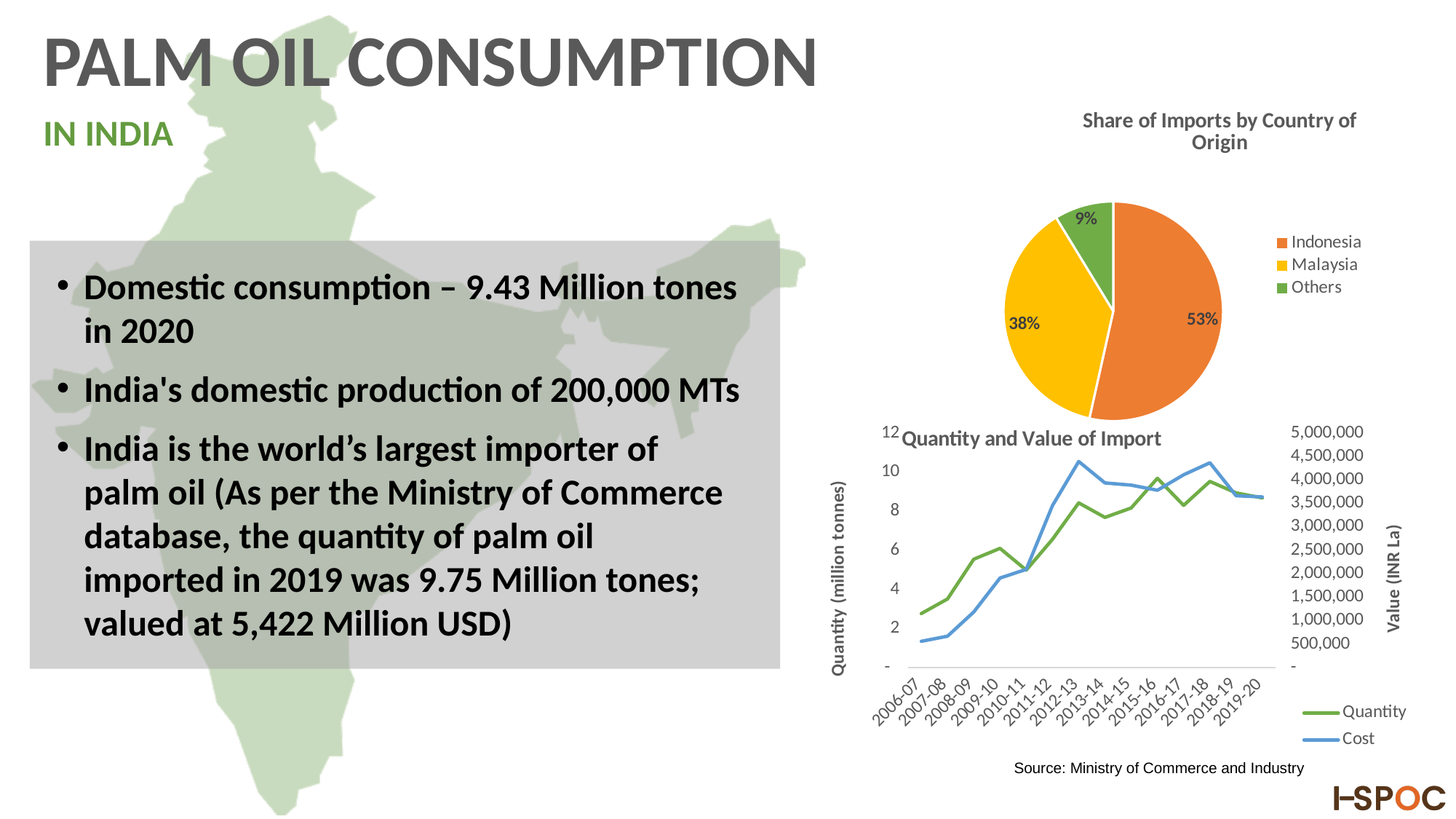
What type of chart is 'Quantity and Value of Import'? Line chart In the 'Share of Imports by Country of Origin' pie chart, what share of imports comes from Indonesia? 53% In the 'Share of Imports by Country of Origin' pie chart, which category has the smallest share? Others In the 'Quantity and Value of Import' chart, how many years are shown on the x axis? 14 In the 'Share of Imports by Country of Origin' pie chart, which country has the largest share? Indonesia In the 'Share of Imports by Country of Origin' pie chart, what share is labelled 'Others'? 9% In the 'Quantity and Value of Import' chart, how many series does the legend list? 2 In the 'Share of Imports by Country of Origin' pie chart, how many slices are there? 3 In the 'Quantity and Value of Import' chart, is the Quantity value for 2006-07 greater or less than 4 million tonnes? less In the 'Share of Imports by Country of Origin' pie chart, what share of imports comes from Malaysia? 38% In the 'Quantity and Value of Import' chart, does the Quantity series generally rise or fall from 2006-07 to 2019-20? Rise In the 'Share of Imports by Country of Origin' pie chart, what is the difference in percentage points between Indonesia's and Malaysia's shares? 15